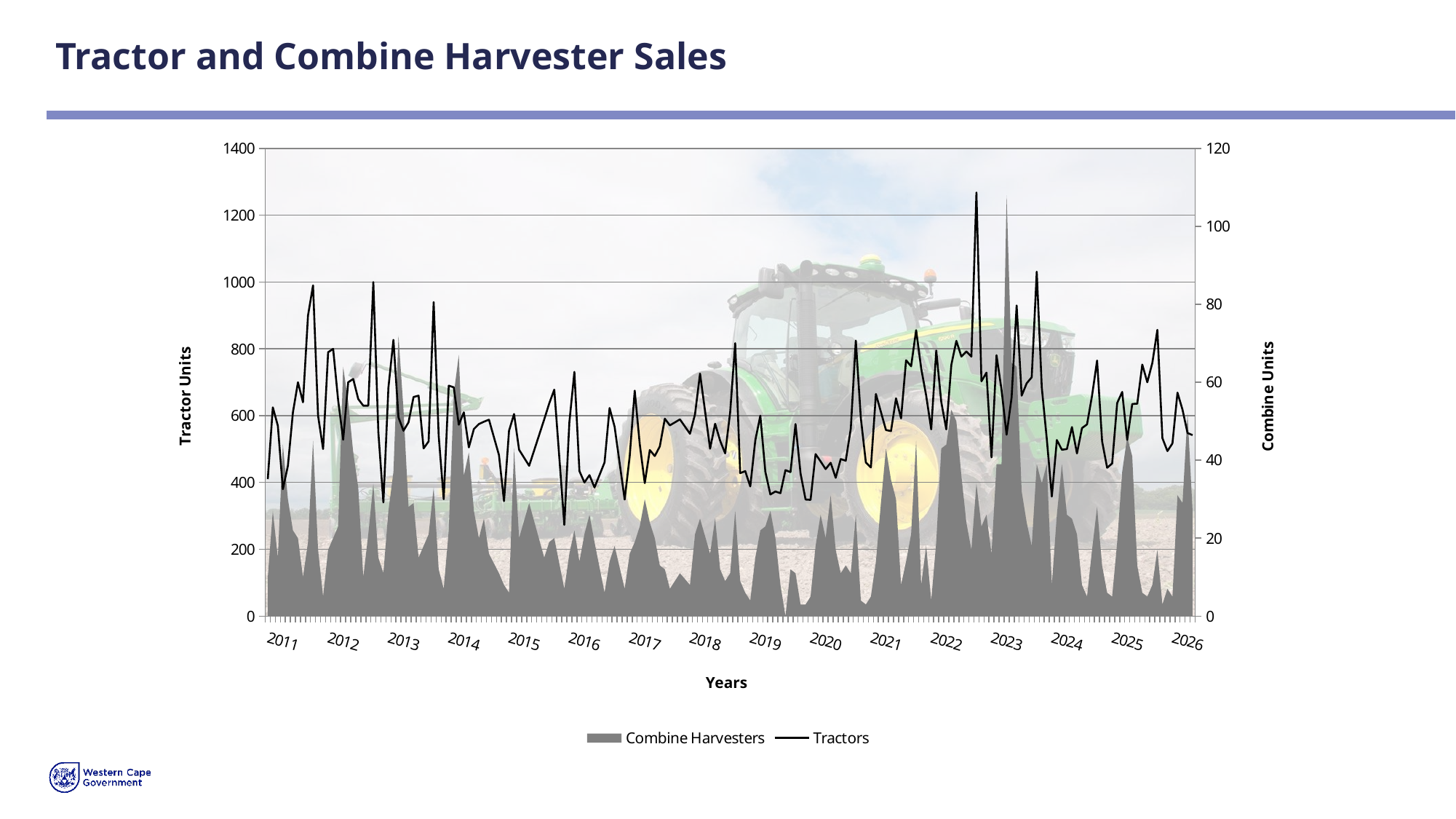
How many year labels are shown on the x axis? 16 In which year does the Tractors line reach its highest peak? 2022 How many series does the legend list? 2 What is the label of the left vertical axis? Tractor Units Which series is drawn as a black line? Tractors What kind of chart is used for the Tractors series? line chart Is the highest value reached by the Combine Harvesters series greater or less than 100? greater Is the highest value reached by the Tractors line greater or less than 1200? greater What is the highest tick value on the left vertical axis (Tractor Units)? 1400 What is the title of the chart? Tractor and Combine Harvester Sales Is the lowest value reached by the Tractors line greater or less than 400? less What is the highest tick value on the right vertical axis (Combine Units)? 120